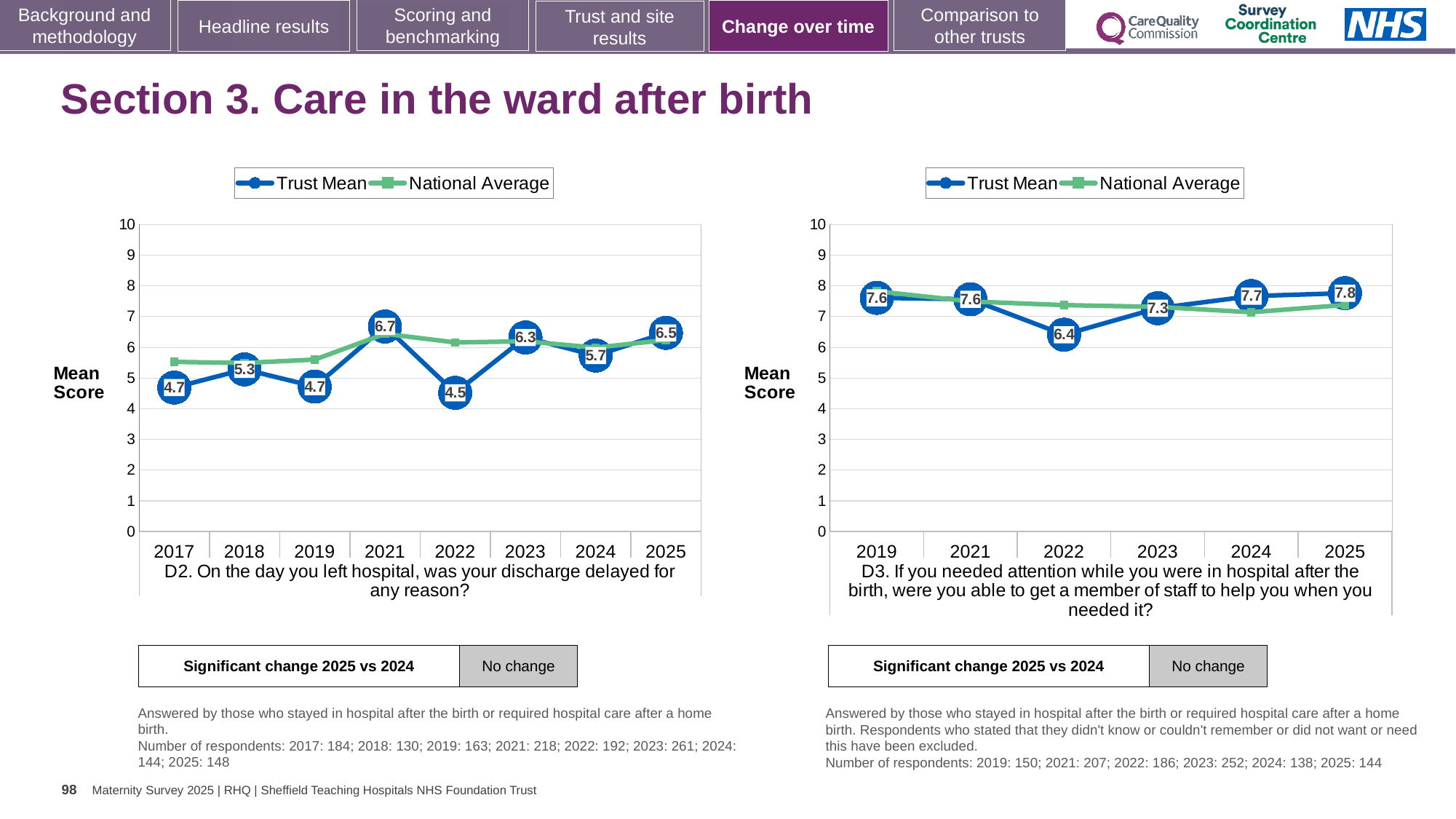
In the right chart (D3, getting staff help), what is the Trust Mean for 2022? 6.4 In the left chart (D2, discharge delayed), what is the Trust Mean for 2022? 4.5 In the right chart (D3, getting staff help), how many series does the legend list? 2 In the left chart (D2, discharge delayed), what is the difference between the Trust Mean for 2021 and 2022? 2.2 In the left chart (D2, discharge delayed), what is the Trust Mean for 2025? 6.5 In the left chart (D2, discharge delayed), how many years are shown on the x axis? 8 In the left chart (D2, discharge delayed), is the National Average for 2017 greater or less than 5? greater In the right chart (D3, getting staff help), which year has the highest Trust Mean? 2025 In the right chart (D3, getting staff help), is the Trust Mean for 2024 larger or smaller than for 2023? larger What type of chart is the right chart (D3, getting staff help)? Line chart In the left chart (D2, discharge delayed), which year has the lowest Trust Mean? 2022 In the left chart (D2, discharge delayed), which year has the highest Trust Mean? 2021